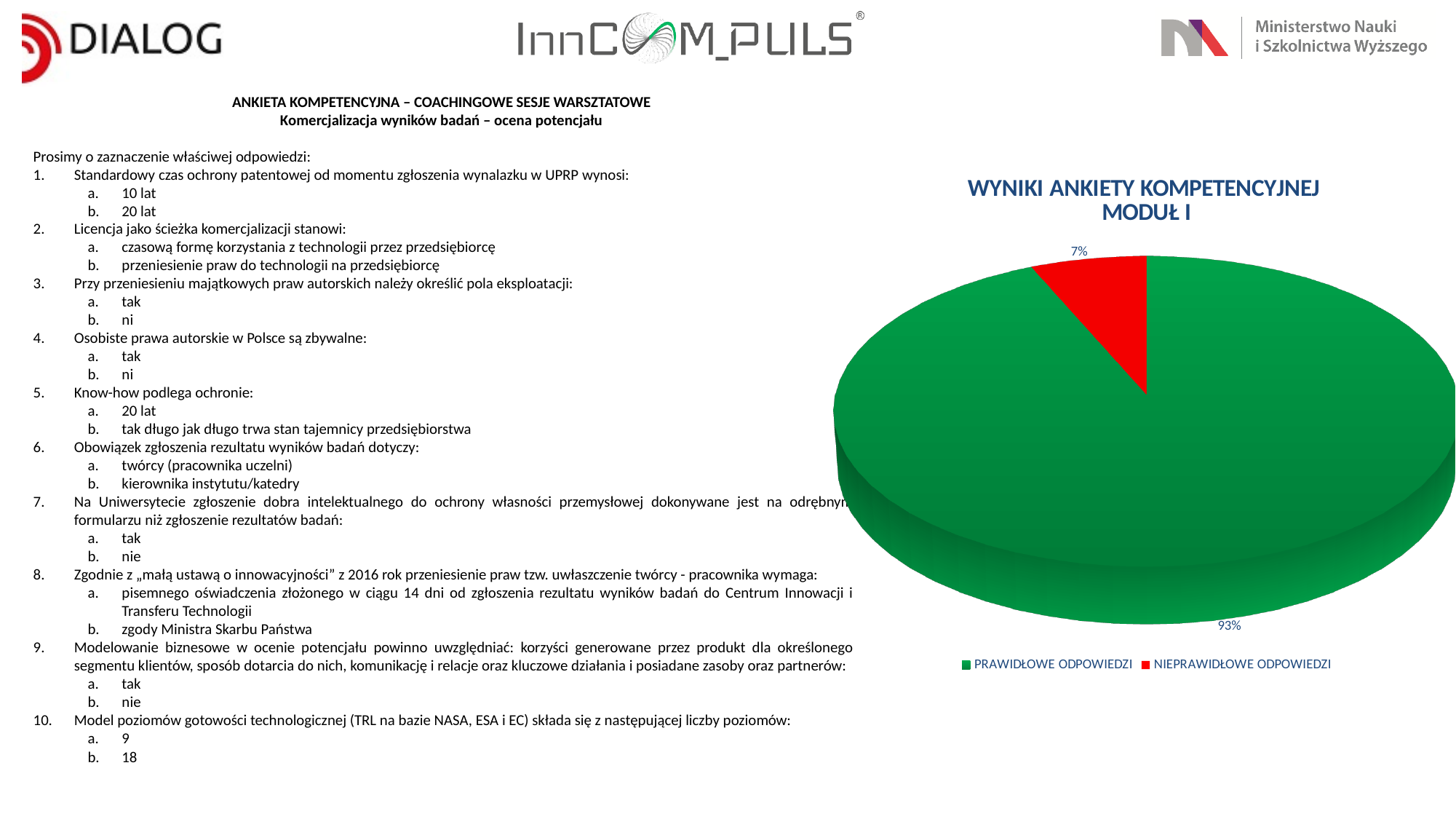
What kind of chart is shown on the slide? pie chart Which slice of the pie is the largest? PRAWIDŁOWE ODPOWIEDZI How many entries does the chart legend list? 2 What is the title of the chart? WYNIKI ANKIETY KOMPETENCYJNEJ MODUŁ I What share of the pie is labelled NIEPRAWIDŁOWE ODPOWIEDZI? 7% What colour is the slice for NIEPRAWIDŁOWE ODPOWIEDZI? red What share of the pie is labelled PRAWIDŁOWE ODPOWIEDZI? 93% How many slices does the pie chart have? 2 Which is larger, the share for PRAWIDŁOWE ODPOWIEDZI or for NIEPRAWIDŁOWE ODPOWIEDZI? PRAWIDŁOWE ODPOWIEDZI What is the difference in percentage points between PRAWIDŁOWE ODPOWIEDZI and NIEPRAWIDŁOWE ODPOWIEDZI? 86 Which slice of the pie is the smallest? NIEPRAWIDŁOWE ODPOWIEDZI